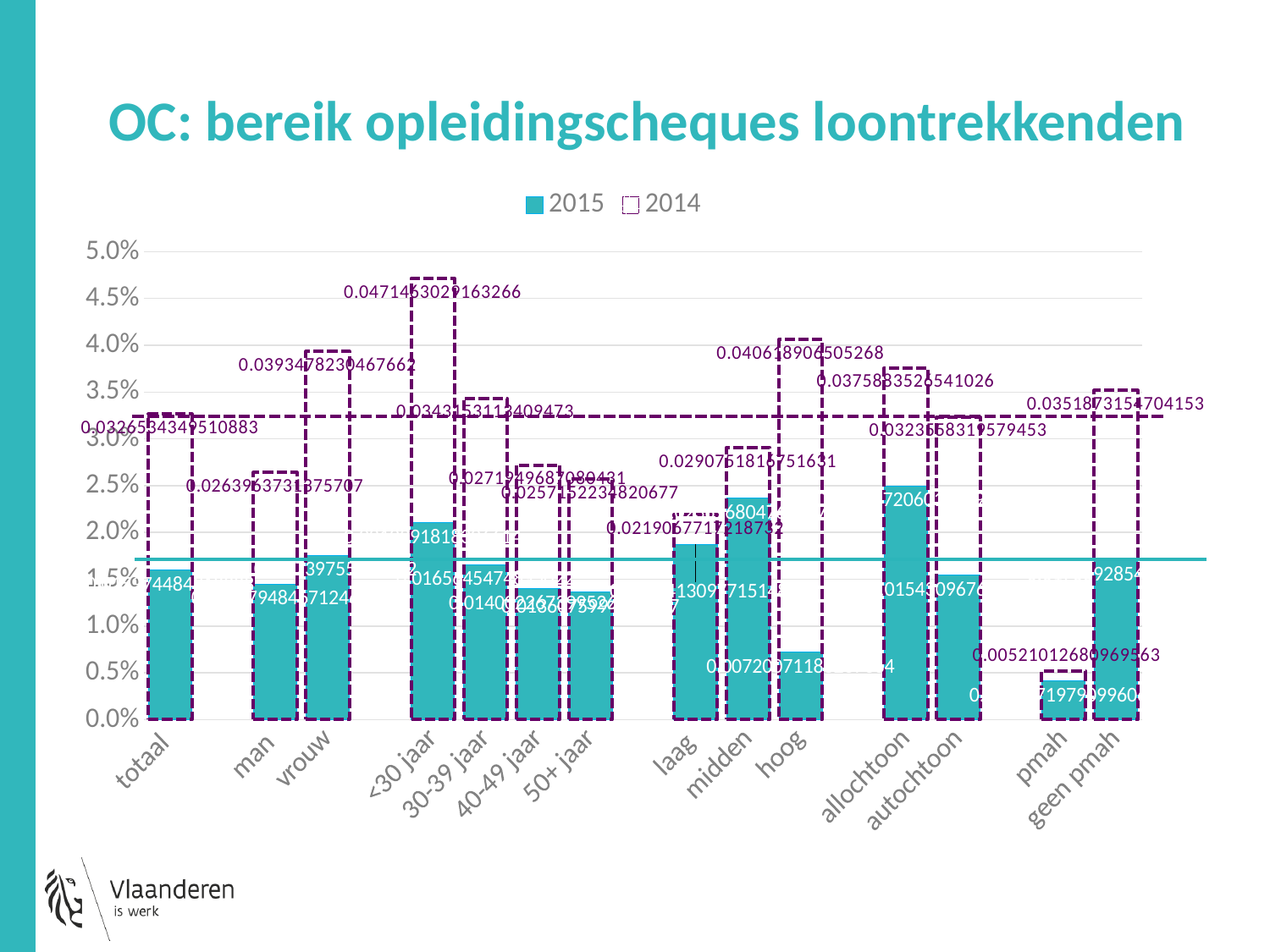
What kind of chart is shown on the slide? bar chart How many series does the legend list? 2 Is the 2015 value for hoog greater or less than 1.0%? less What is the title of the chart? OC: bereik opleidingscheques loontrekkenden Which category has the highest 2014 value? <30 jaar Which category has the lowest 2014 value? pmah Is the 2014 value for <30 jaar greater or less than 4.5%? greater Is the 2015 value for allochtoon greater or less than 2.0%? greater For totaal, which is larger: the 2014 value or the 2015 value? 2014 Which category has the lowest 2015 value? pmah Which is larger in 2015: midden or hoog? midden How many categories are shown along the x axis? 14